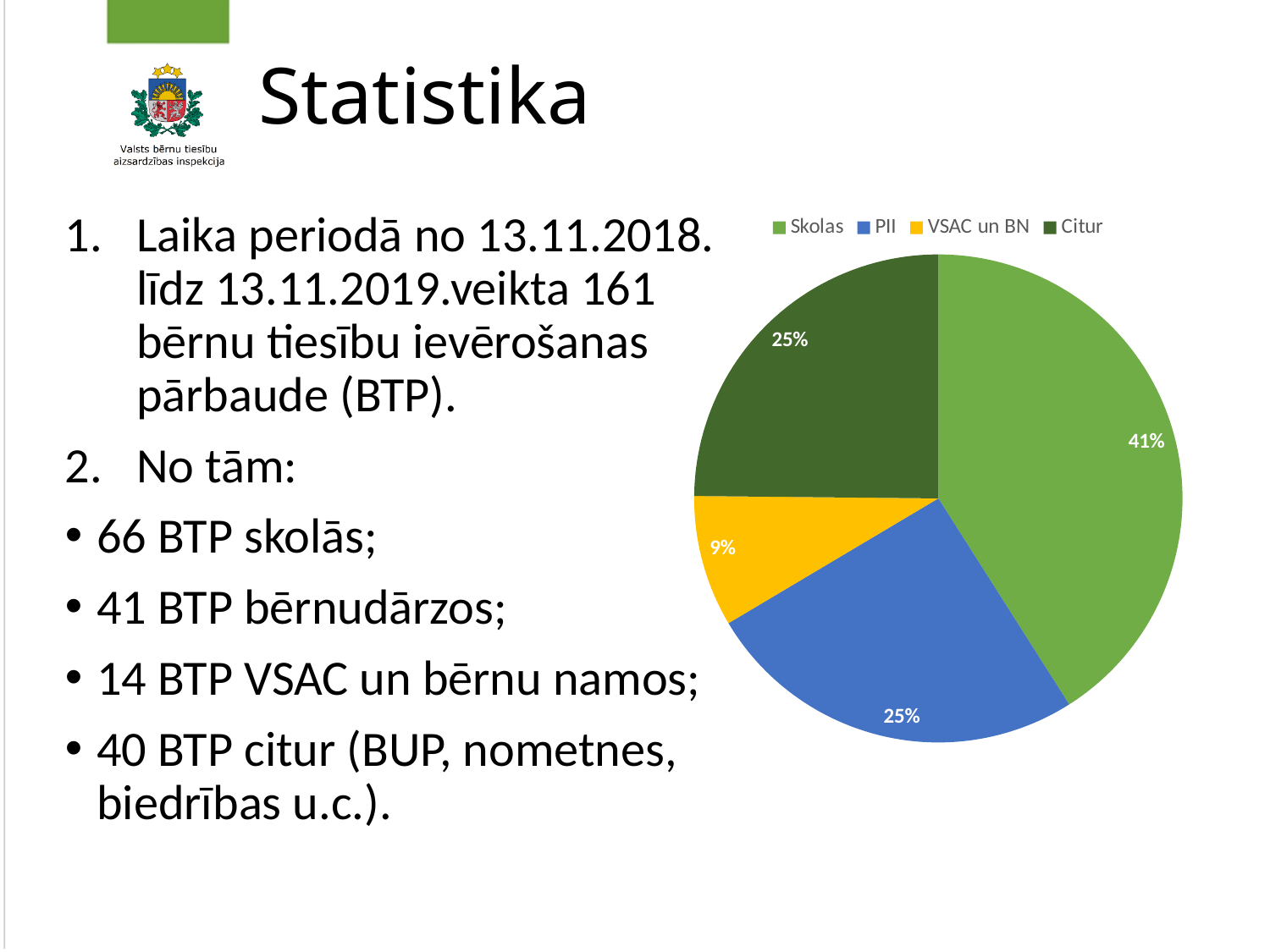
What is the difference in percentage points between Skolas and PII? 16 What type of chart is shown on the slide? pie chart What colour is the slice for VSAC un BN? yellow What percentage is shown for PII? 25% What percentage is shown for VSAC un BN? 9% How many entries does the legend list? 4 What percentage is shown for Citur? 25% Which category has the smallest slice of the pie? VSAC un BN Which category has the largest slice of the pie? Skolas What share of the pie does Skolas take? 41% How many slices does the pie chart have? 4 Which is larger, the share for Skolas or the share for VSAC un BN? Skolas